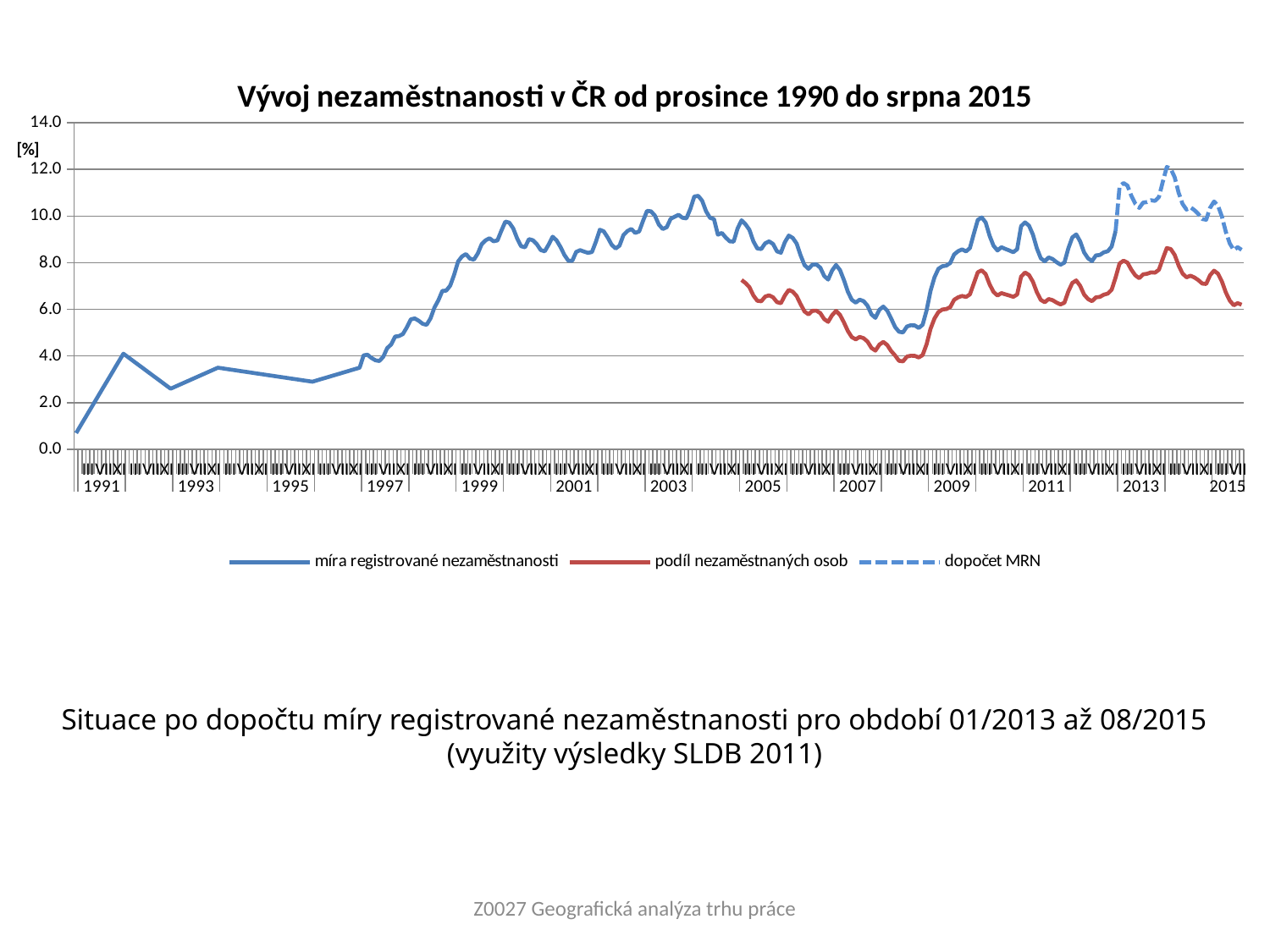
Which series is drawn with a dashed line? dopočet MRN How many series does the legend list? 3 What is the title of the chart? Vývoj nezaměstnanosti v ČR od prosince 1990 do srpna 2015 What is the highest value shown on the vertical axis? 14.0 Does míra registrované nezaměstnanosti generally rise or fall between 1995 and 1999? rise Is the highest value of dopočet MRN (around 2014) greater or less than 10.0? greater Is the value of míra registrované nezaměstnanosti at the start of the series (end of 1990) greater or less than 2.0? less Does podíl nezaměstnaných osob generally rise or fall between 2005 and 2008? fall What kind of chart is shown on the slide? line chart In 2005, which series has the higher value: míra registrované nezaměstnanosti or podíl nezaměstnaných osob? míra registrované nezaměstnanosti Is the peak value of míra registrované nezaměstnanosti around 2004 greater or less than 10.0? greater